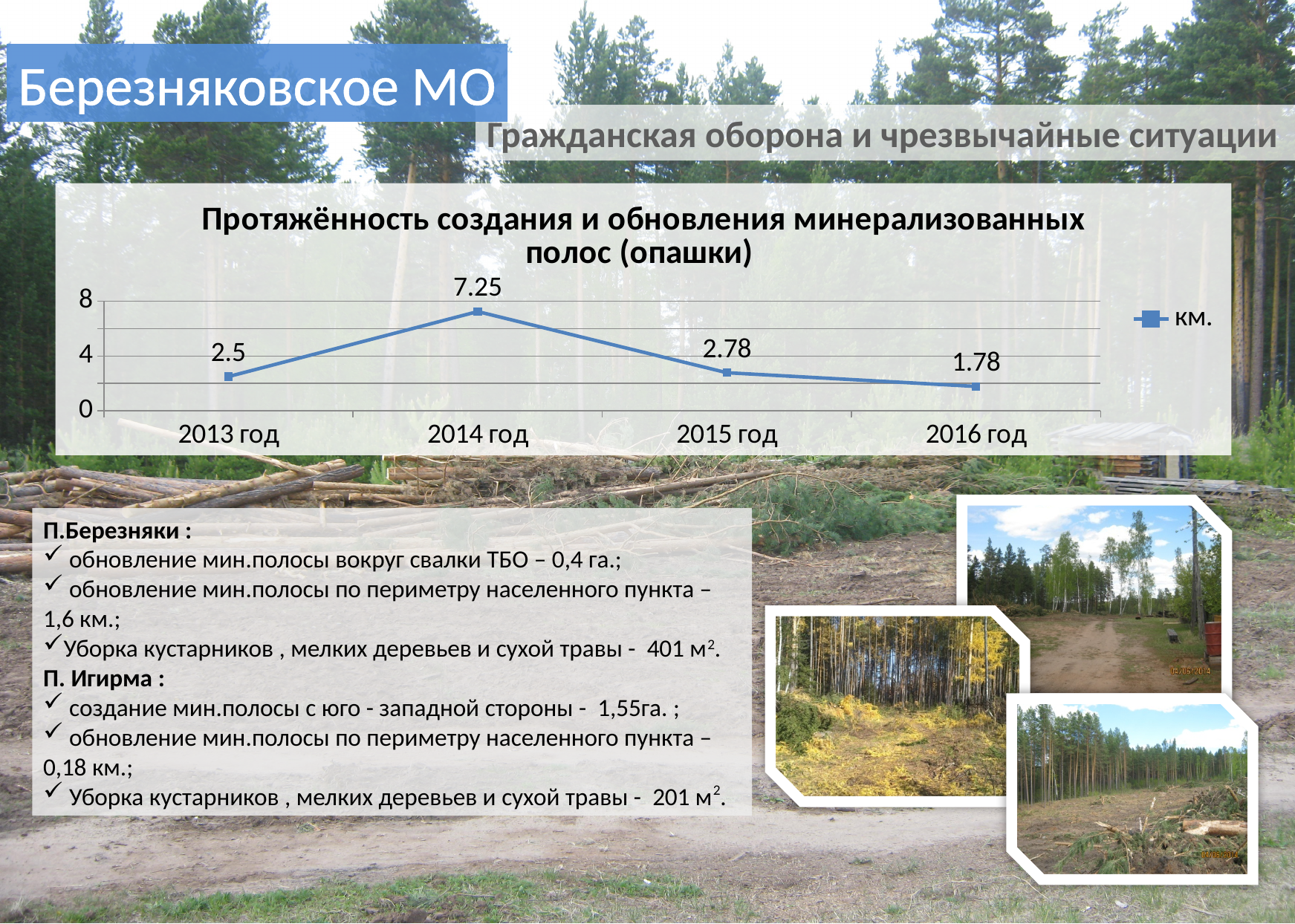
How many years are plotted on the chart? 4 What is the value for 2016 год? 1.78 How many series does the legend list? 1 What is the difference between the values for 2014 год and 2015 год? 4.47 Which is larger, the value for 2013 год or the value for 2015 год? 2015 год Do the values rise or fall from 2014 год to 2016 год? fall Which year has the highest value? 2014 год What is the value for 2013 год? 2.5 Is the value for 2014 год greater or less than 4? greater Which year has the lowest value? 2016 год What is the value for 2014 год? 7.25 What kind of chart is shown on the slide? line chart